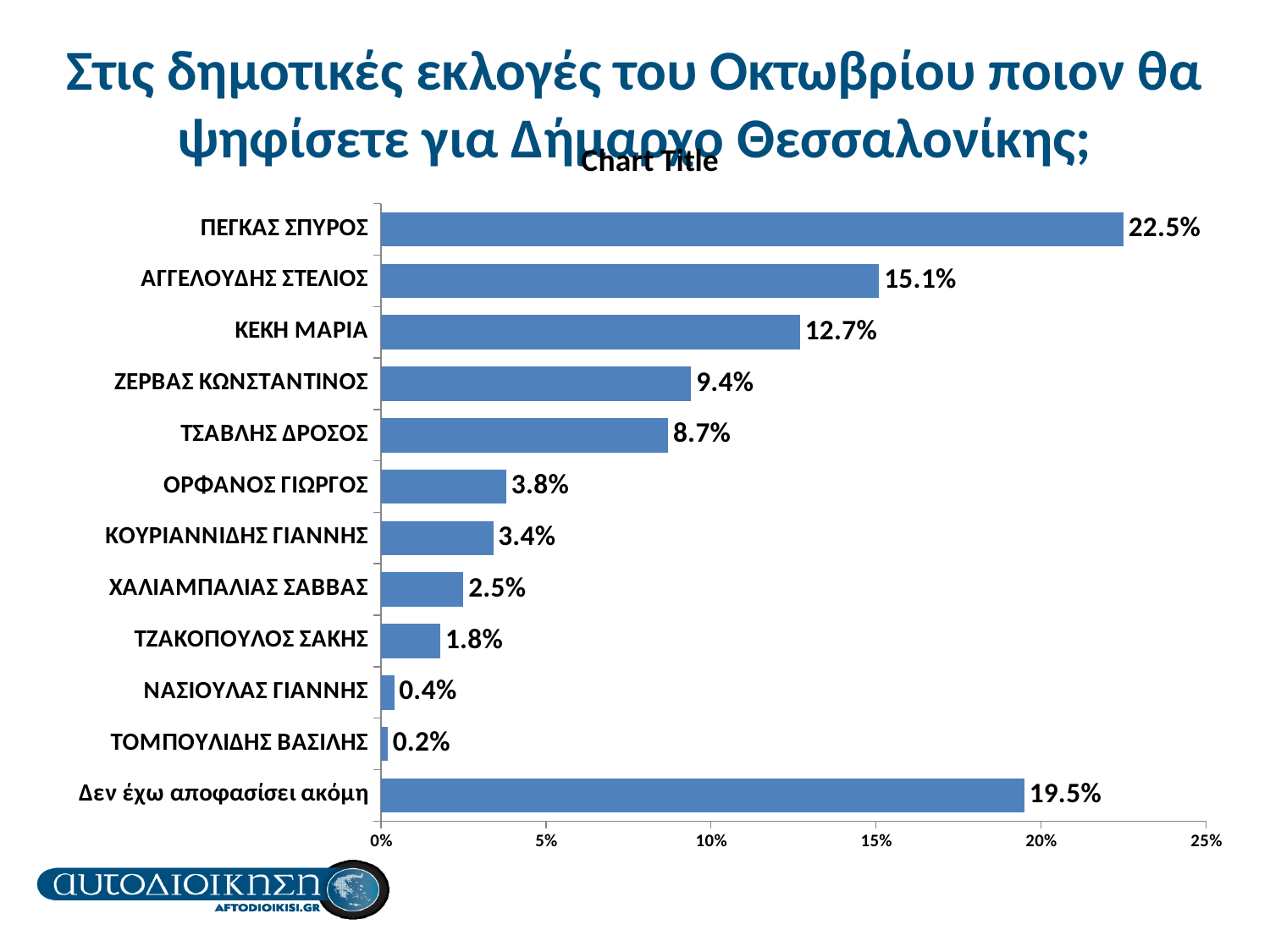
What is the value for Δεν έχω αποφασίσει ακόμη? 19.5% What is the value for ΚΕΚΗ ΜΑΡΙΑ? 12.7% What is the difference between the values for ΟΡΦΑΝΟΣ ΓΙΩΡΓΟΣ and ΧΑΛΙΑΜΠΑΛΙΑΣ ΣΑΒΒΑΣ? 1.3% What is the value for ΠΕΓΚΑΣ ΣΠΥΡΟΣ? 22.5% Which is larger, the value for ΖΕΡΒΑΣ ΚΩΝΣΤΑΝΤΙΝΟΣ or ΤΣΑΒΛΗΣ ΔΡΟΣΟΣ? ΖΕΡΒΑΣ ΚΩΝΣΤΑΝΤΙΝΟΣ Which category has the lowest value? ΤΟΜΠΟΥΛΙΔΗΣ ΒΑΣΙΛΗΣ What is the value for ΚΟΥΡΙΑΝΝΙΔΗΣ ΓΙΑΝΝΗΣ? 3.4% Is the value for ΑΓΓΕΛΟΥΔΗΣ ΣΤΕΛΙΟΣ greater or less than 10%? greater How many categories are shown in the chart? 12 What kind of chart is shown on the slide? bar chart Which category has the highest value? ΠΕΓΚΑΣ ΣΠΥΡΟΣ What is the difference between the values for ΠΕΓΚΑΣ ΣΠΥΡΟΣ and ΑΓΓΕΛΟΥΔΗΣ ΣΤΕΛΙΟΣ? 7.4%